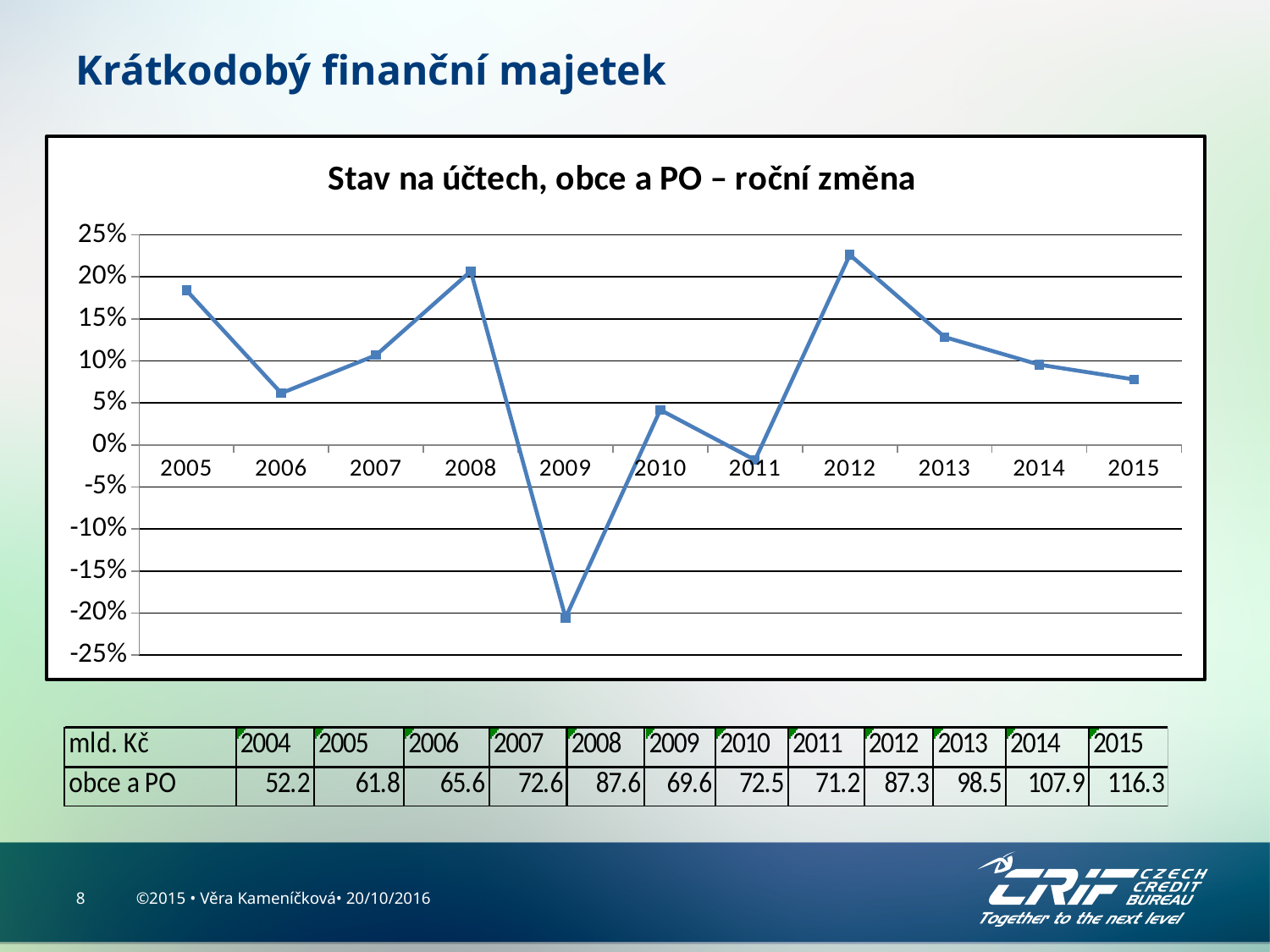
Is the value for 2015 greater or less than 10%? less Is the value for 2005 greater or less than 15%? greater Do the values rise or fall from 2012 to 2015? fall How many years are plotted on the x axis of the chart? 11 Which year has the lowest value in the chart? 2009 Which year has the highest value in the chart? 2012 What kind of chart is shown on the slide? line chart What is the title of the chart? Stav na účtech, obce a PO – roční změna Is the value for 2012 greater or less than 20%? greater Which year has the larger value, 2005 or 2006? 2005